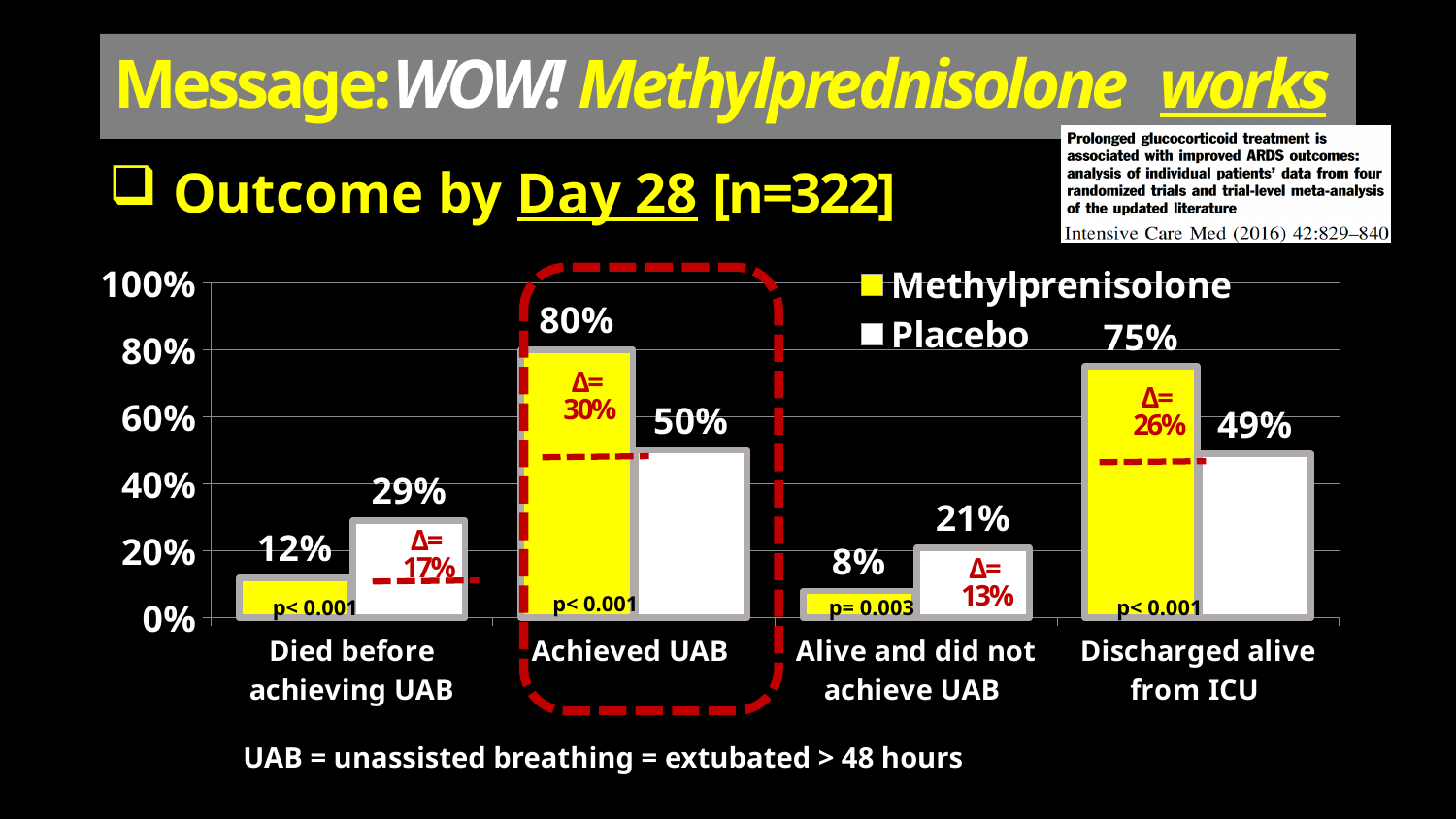
What is the Placebo value for Discharged alive from ICU? 49% What is the Methylprenisolone value for Achieved UAB? 80% Which category has the highest Methylprenisolone value? Achieved UAB Which colour represents the Placebo series? White Which is larger for Died before achieving UAB, the Methylprenisolone value or the Placebo value? Placebo What is the difference between the Methylprenisolone and Placebo values for Discharged alive from ICU? 26% What is the Placebo value for Died before achieving UAB? 29% What kind of chart is shown on the slide? Bar chart How many series does the legend list? 2 What is the Methylprenisolone value for Alive and did not achieve UAB? 8% How many categories are shown on the x axis? 4 Which category has the lowest Placebo value? Alive and did not achieve UAB